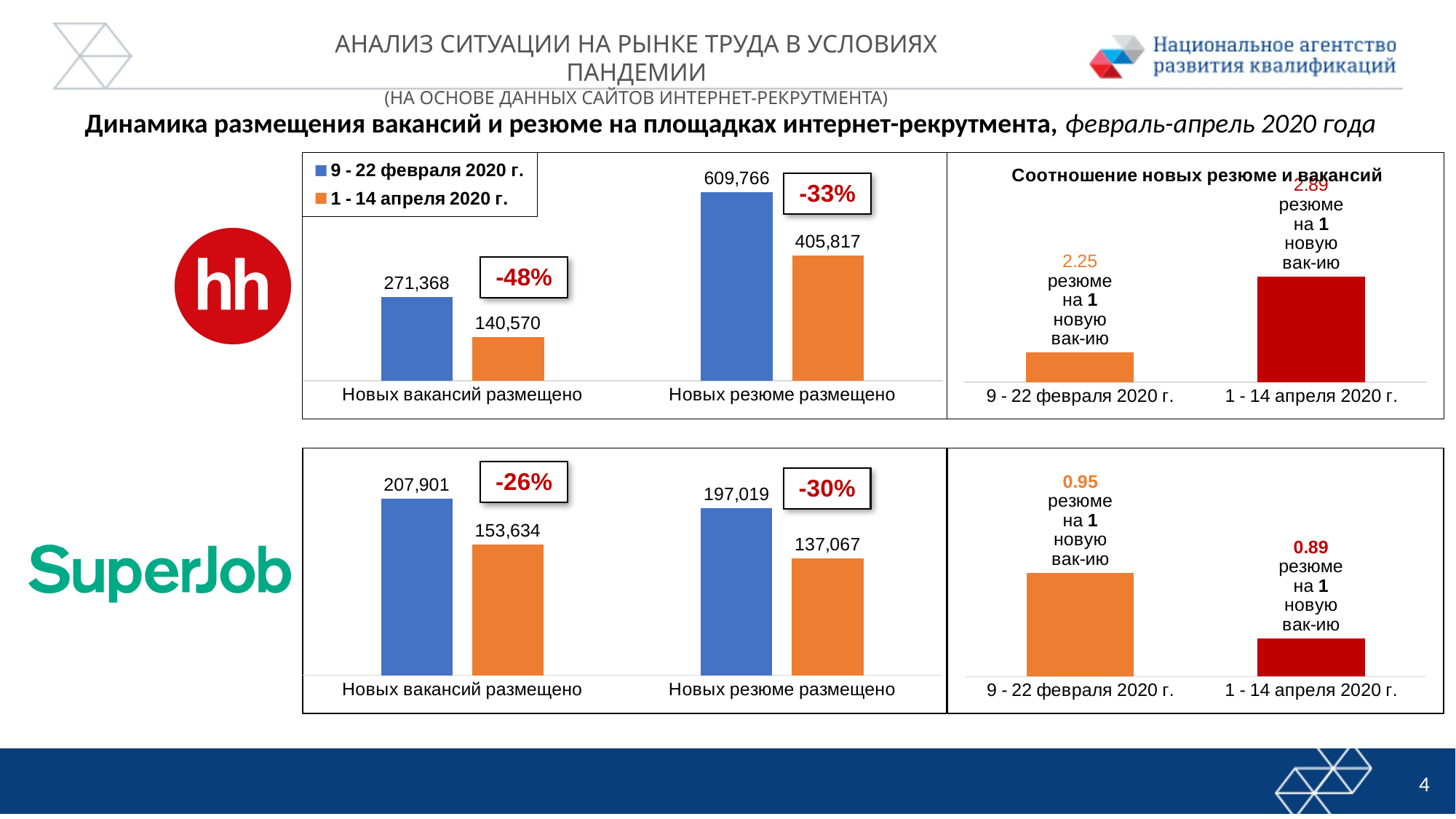
In the SuperJob ratio chart (bottom right), what is the number of resumes per new vacancy for 9 - 22 февраля 2020 г.? 0.95 In the hh chart (top left), what percentage change is shown for new vacancies posted? -48% In the SuperJob chart (bottom left), how many new vacancies were posted in 1 - 14 апреля 2020 г.? 153,634 In the SuperJob chart (bottom left), how many new resumes were posted in 9 - 22 февраля 2020 г.? 197,019 In the hh chart (top left), how many new resumes were posted in 1 - 14 апреля 2020 г.? 405,817 In the hh chart (top left), what is the difference between new vacancies posted in 9 - 22 февраля 2020 г. and in 1 - 14 апреля 2020 г.? 130,798 How many series does the legend in the hh chart (top left) list? 2 In the hh ratio chart (top right, 'Соотношение новых резюме и вакансий'), what is the number of resumes per new vacancy for 1 - 14 апреля 2020 г.? 2.89 In the SuperJob ratio chart (bottom right), which period has the lower ratio of resumes per new vacancy? 1 - 14 апреля 2020 г. In the SuperJob chart (bottom left), which is larger: new vacancies posted in 9 - 22 февраля 2020 г. or new resumes posted in 9 - 22 февраля 2020 г.? Новых вакансий размещено In the hh chart (top left), how many new vacancies were posted in 9 - 22 февраля 2020 г.? 271,368 In the SuperJob chart (bottom left), what is the difference between new resumes posted in 9 - 22 февраля 2020 г. and in 1 - 14 апреля 2020 г.? 59,952